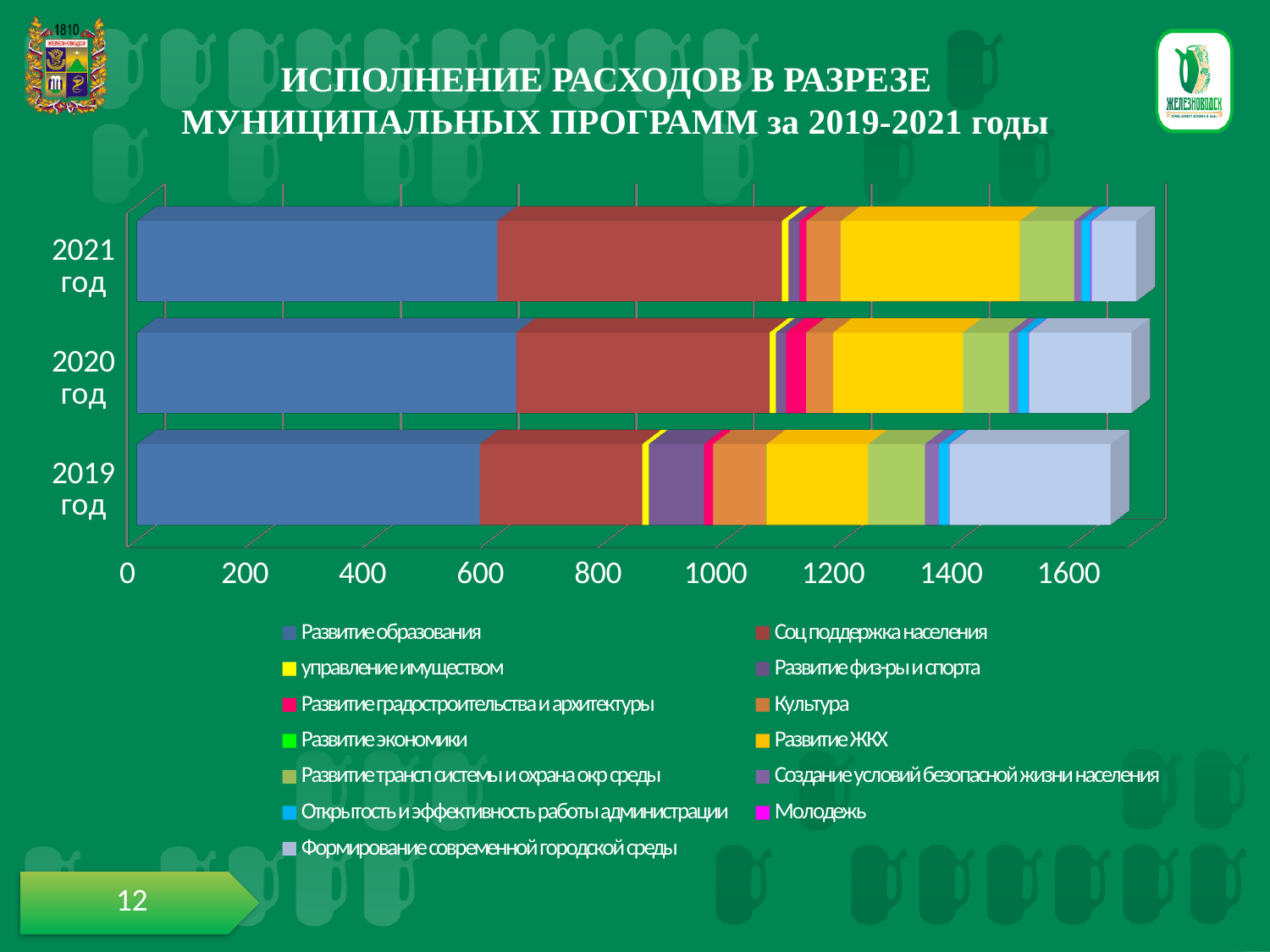
In which year is the Развитие ЖКХ segment the largest? 2021 год Is the total length of the 2019 год bar greater or less than 1400? greater In which year is the Формирование современной городской среды segment the largest? 2019 год Is the value for Развитие образования in 2021 год greater or less than 400? greater How many years (categories) are shown on the chart? 3 Which colour represents Развитие образования in the legend? blue How many series does the legend list? 13 Which is larger: the Развитие физ-ры и спорта segment in 2019 год or in 2021 год? 2019 год What kind of chart is shown on the slide? stacked bar chart Is the total length of the 2021 год bar greater or less than 1200? greater What is the title of the chart on the slide? ИСПОЛНЕНИЕ РАСХОДОВ В РАЗРЕЗЕ МУНИЦИПАЛЬНЫХ ПРОГРАММ за 2019-2021 годы In which year is the Соц поддержка населения segment the smallest? 2019 год